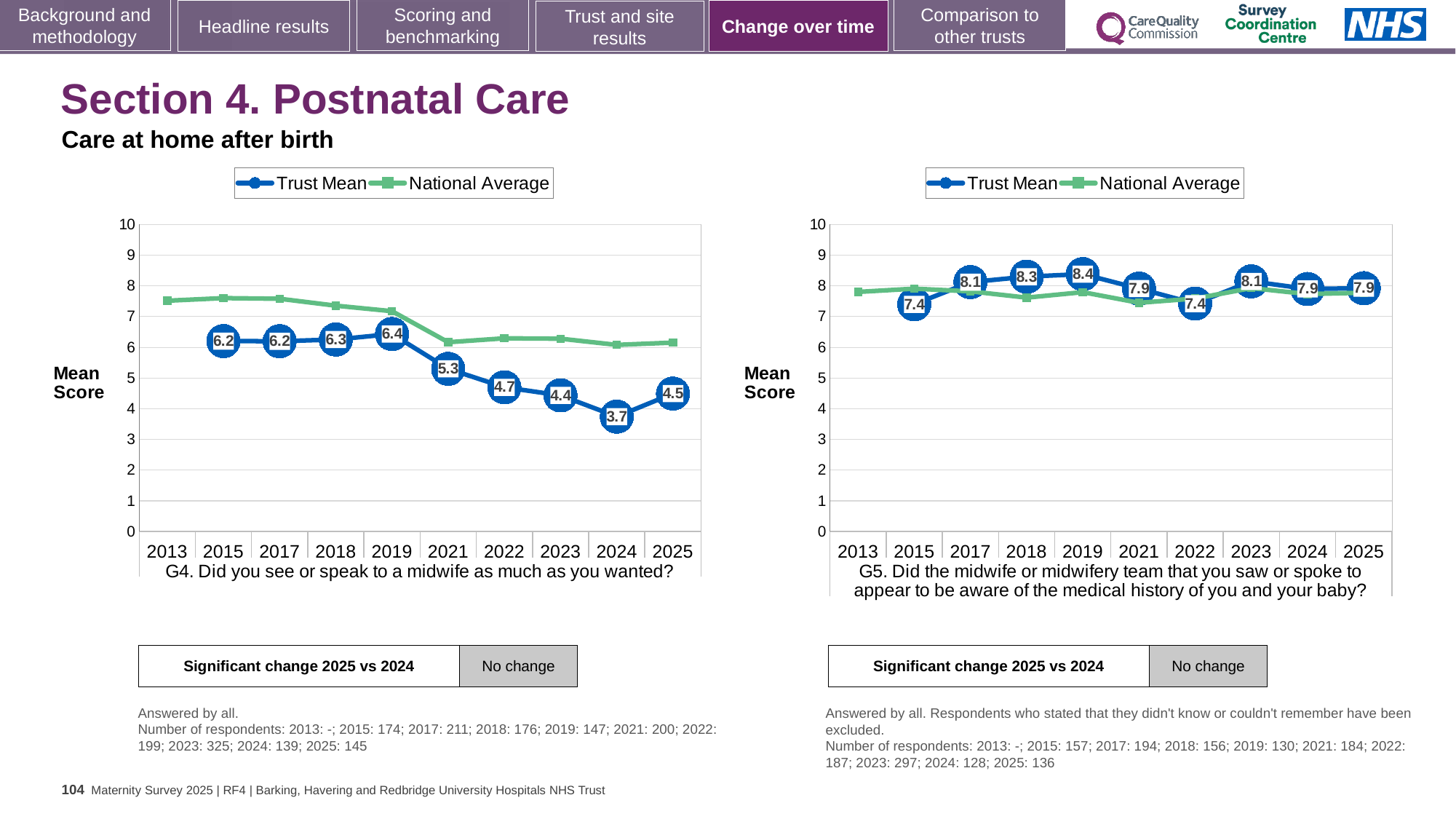
In the G4 chart on the left, what is the difference between the Trust Mean for 2025 and 2024? 0.8 In the G5 chart on the right, which is larger, the Trust Mean for 2018 or for 2022? 2018 In the G5 chart on the right, what is the Trust Mean for 2019? 8.4 How many series does the legend of the G4 chart on the left list? 2 What kind of chart is the G5 chart on the right? Line chart How many years are shown on the x axis of the G5 chart on the right? 10 In the G4 chart on the left, which year has the lowest Trust Mean? 2024 In the G4 chart on the left, does the Trust Mean rise or fall from 2019 to 2024? Fall In the G4 chart on the left, what is the Trust Mean for 2024? 3.7 In the G4 chart on the left, is the National Average for 2013 greater or less than 7? greater In the G5 chart on the right, which year has the highest Trust Mean? 2019 In the G4 chart on the left, is the National Average for 2025 greater or less than 7? less